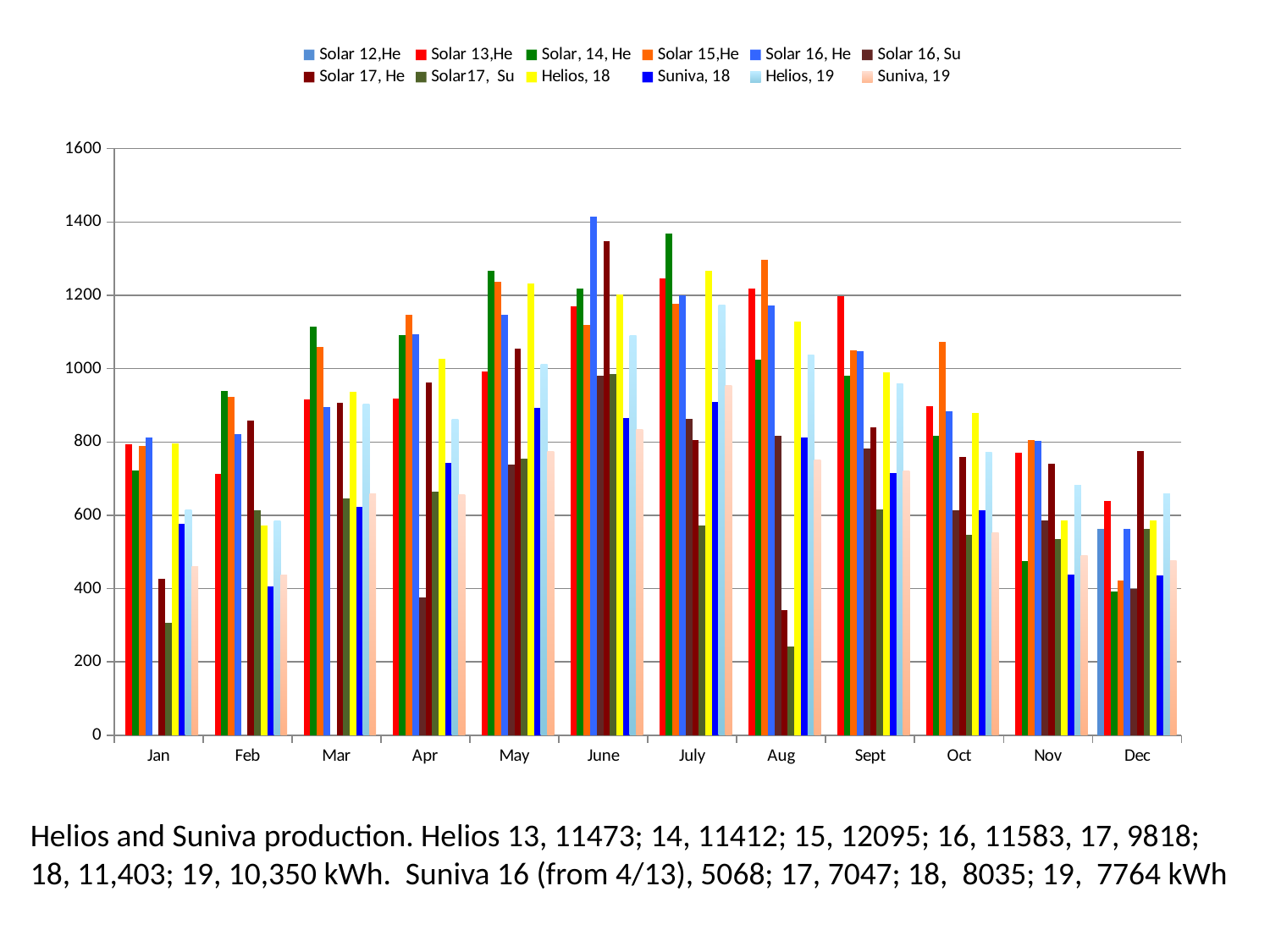
Is the value for Solar17, Su in Aug greater or less than 400? less Is the value for Helios, 18 in Jan greater or less than 1000? less Is the value for Solar 16, He in June greater or less than 1200? greater What is the highest value shown on the vertical axis? 1600 In Aug, which is larger: Solar 15,He or Solar 13,He? Solar 15,He How many months are shown along the x axis? 12 How many series does the legend list? 12 What kind of chart is shown on the slide? bar chart In which month does the tallest bar on the chart appear? June